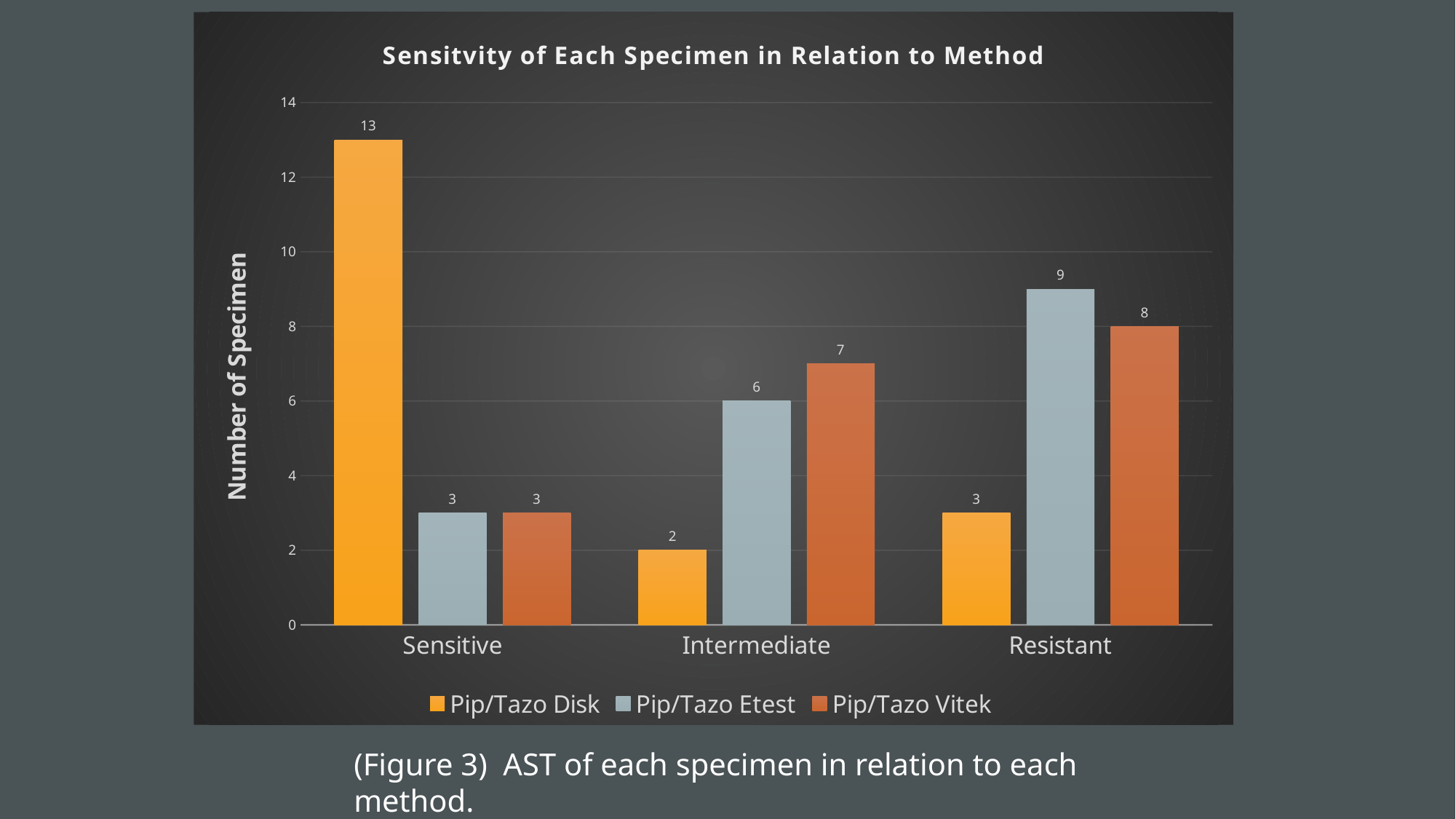
Which category has the lowest value for Pip/Tazo Etest? Sensitive Which category has the highest value for Pip/Tazo Disk? Sensitive What is the title of the chart? Sensitvity of Each Specimen in Relation to Method Do the Pip/Tazo Etest values rise or fall from Sensitive to Resistant? Rise What is the value for Pip/Tazo Etest in the Resistant category? 9 How many series does the legend list? 3 What is the difference between the Pip/Tazo Disk value and the Pip/Tazo Etest value in the Sensitive category? 10 In the Resistant category, which is larger: Pip/Tazo Etest or Pip/Tazo Vitek? Pip/Tazo Etest What is the value for Pip/Tazo Disk in the Sensitive category? 13 What is the value for Pip/Tazo Vitek in the Intermediate category? 7 How many categories are shown on the x axis? 3 What kind of chart is shown on the slide? Bar chart